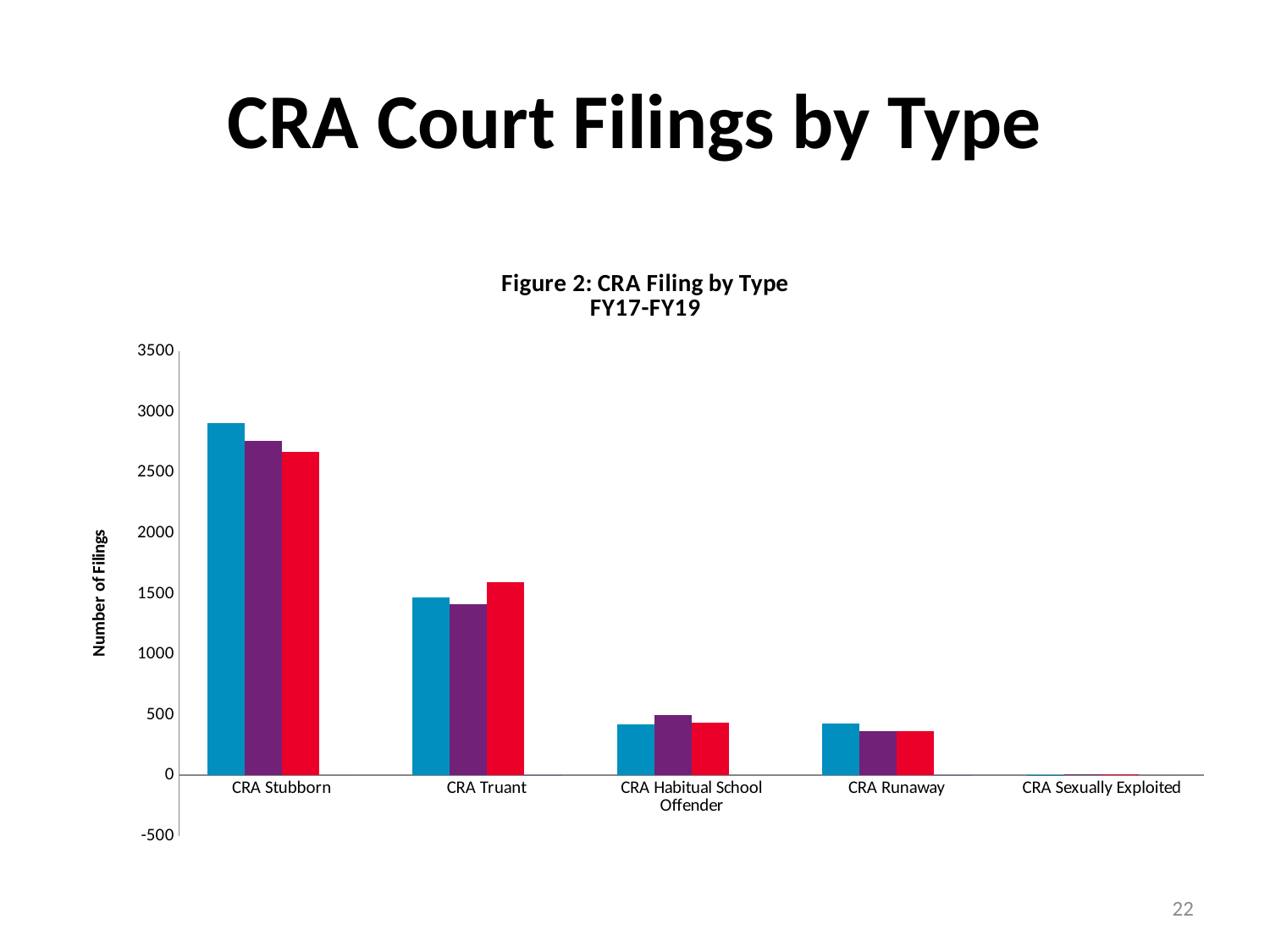
What is the title of the chart? Figure 2: CRA Filing by Type FY17-FY19 What type of chart is shown on the slide? bar chart Is the value of the tallest bar for CRA Runaway greater or less than 500? less How many filing type categories are shown on the x axis? 5 Is the value of the tallest bar for CRA Stubborn greater or less than 2500? greater What is the label on the vertical axis of the chart? Number of Filings Which filing type has the lowest number of filings? CRA Sexually Exploited Which filing type has the highest number of filings? CRA Stubborn Do the number of filings generally rise or fall moving from left to right across the categories? fall Which has more filings, CRA Stubborn or CRA Truant? CRA Stubborn Is the value of the red bar for CRA Truant greater or less than 1500? greater